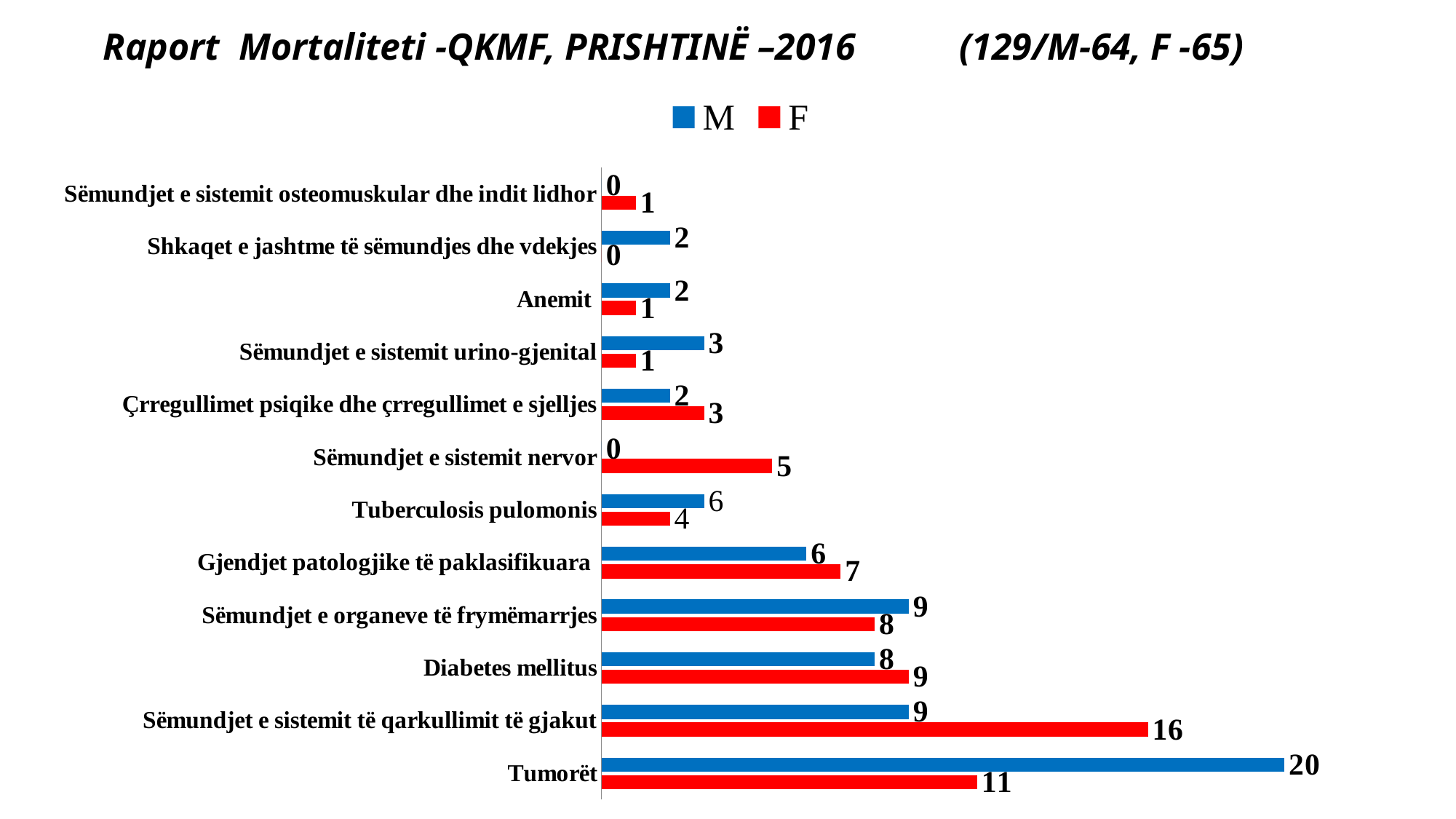
What is the M value for Tuberculosis pulomonis? 6 What is the difference between the M and F values for Tumorët? 9 What is the F value for Sëmundjet e sistemit nervor? 5 How many series does the legend list? 2 What is the M value for Tumorët? 20 Which category has the highest M value? Tumorët What kind of chart is shown on the slide? Bar chart What is the difference between the F and M values for Sëmundjet e sistemit të qarkullimit të gjakut? 7 Which category has the highest F value? Sëmundjet e sistemit të qarkullimit të gjakut Which is larger for Diabetes mellitus, the M value or the F value? F How many categories are shown on the chart? 12 What is the F value for Sëmundjet e sistemit të qarkullimit të gjakut? 16